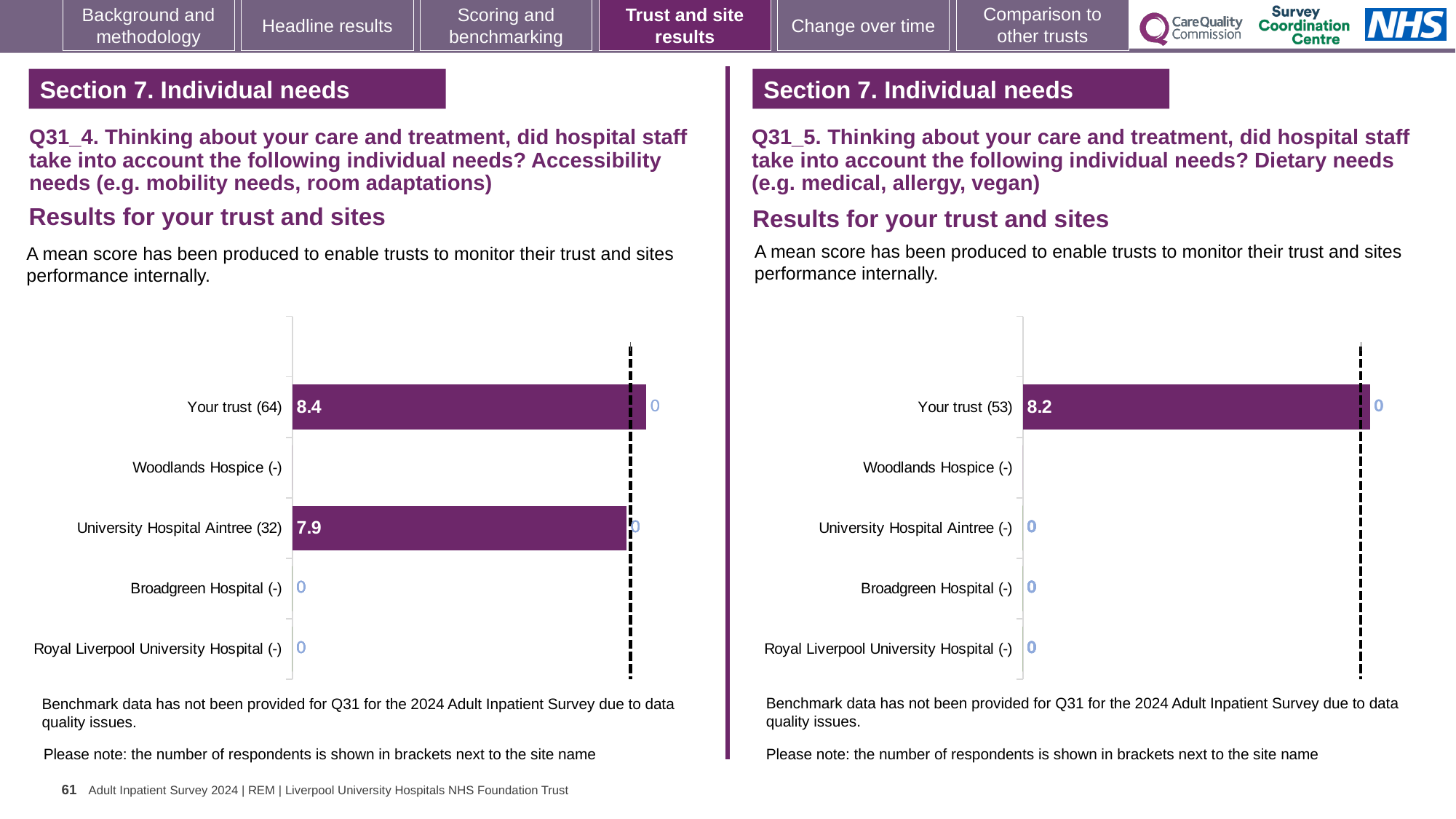
In the Q31_5 chart on the right, what is the mean score for Your trust? 8.2 In the Q31_4 chart on the left, which category has the highest mean score? Your trust In the Q31_4 chart on the left, what is the mean score for Your trust? 8.4 In the Q31_4 chart on the left, what is the difference between the mean score for Your trust and the mean score for University Hospital Aintree? 0.5 Which chart shows a higher mean score for Your trust, the Q31_4 chart on the left or the Q31_5 chart on the right? Q31_4 chart on the left How many categories are listed on the vertical axis of the Q31_5 chart on the right? 5 In the Q31_4 chart on the left, which has the higher mean score, Your trust or University Hospital Aintree? Your trust In the Q31_4 chart on the left, how many respondents are shown in brackets for University Hospital Aintree? 32 How many categories are listed on the vertical axis of the Q31_4 chart on the left? 5 What kind of chart is used in the Q31_5 chart on the right? Bar chart In the Q31_5 chart on the right, how many respondents are shown in brackets for Your trust? 53 In the Q31_4 chart on the left, what is the mean score for University Hospital Aintree? 7.9